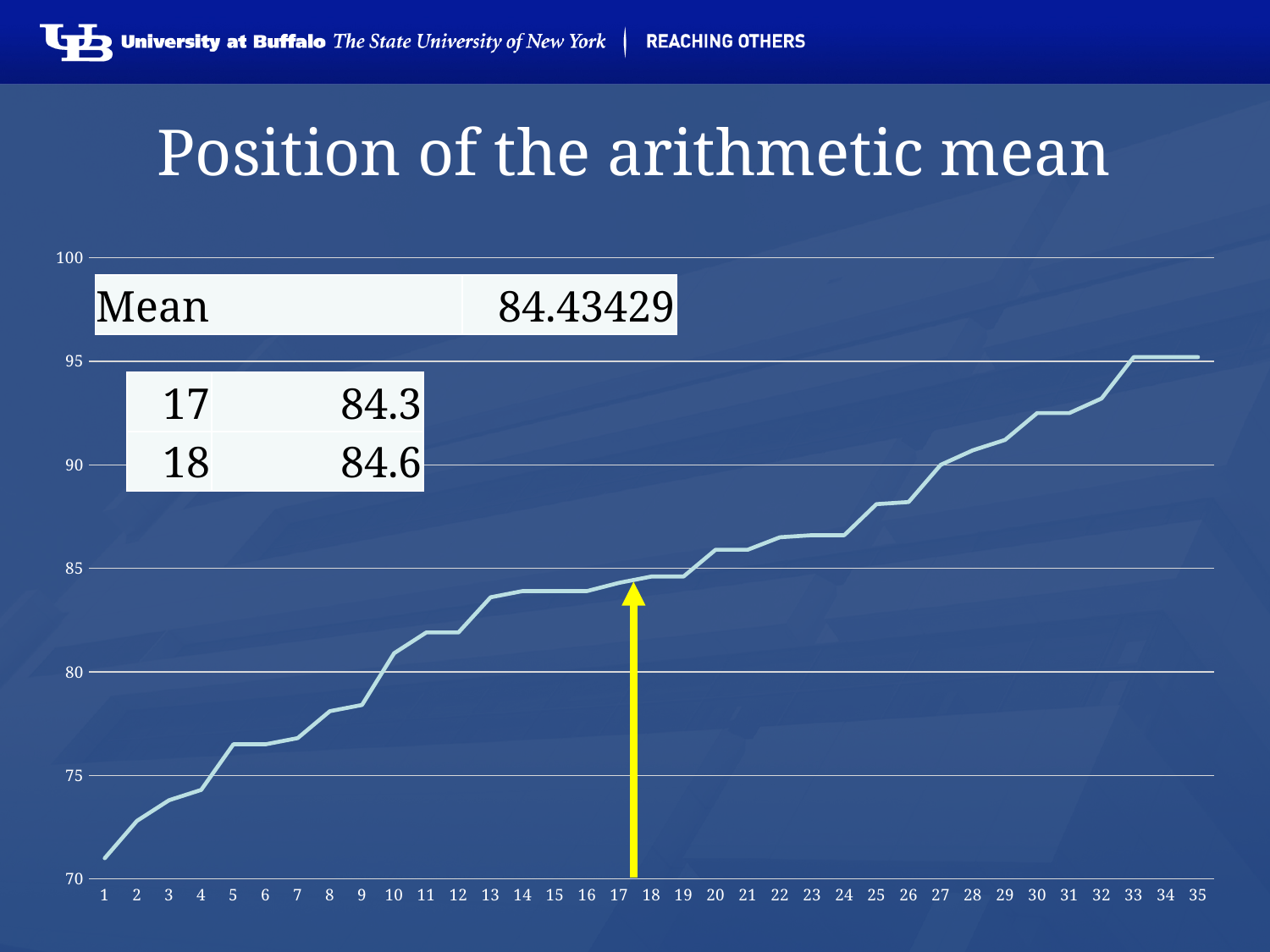
What is the difference between the values at positions 18 and 17? 0.3 Do the values rise or fall as the x axis goes from 1 to 35? rise What kind of chart is shown on the slide? line chart What is the mean value printed on the slide? 84.43429 How many points are plotted along the x axis? 35 Is the value for position 1 greater or less than 75? less Is the value for position 25 greater or less than 85? greater Which position has the lowest value? 1 What is the title of the chart? Position of the arithmetic mean What is the value shown for position 18? 84.6 What is the value shown for position 17? 84.3 Which has the larger value, position 17 or position 18? 18